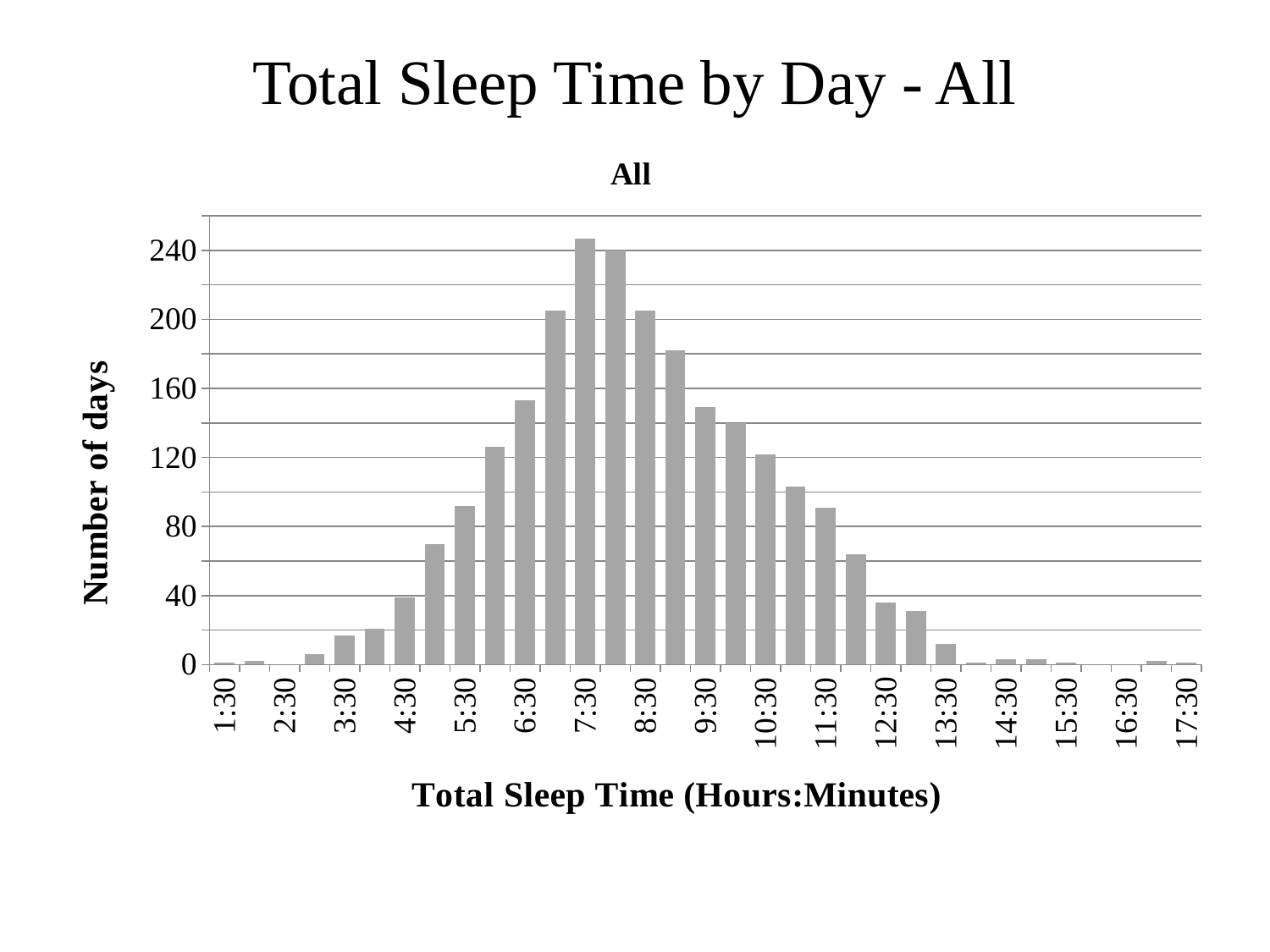
Do the values rise or fall along the x axis from 8:30 to 13:30? fall Is the number of days for 8:30 greater or less than 200? greater Which has more days, 8:30 or 9:30? 8:30 Is the number of days for 7:30 greater or less than 240? greater Which has more days, 6:30 or 10:30? 6:30 Is the number of days for 5:30 greater or less than 80? greater What kind of chart is shown on the slide? bar chart Which total sleep time has the highest number of days? 7:30 What is the title of the x axis? Total Sleep Time (Hours:Minutes)